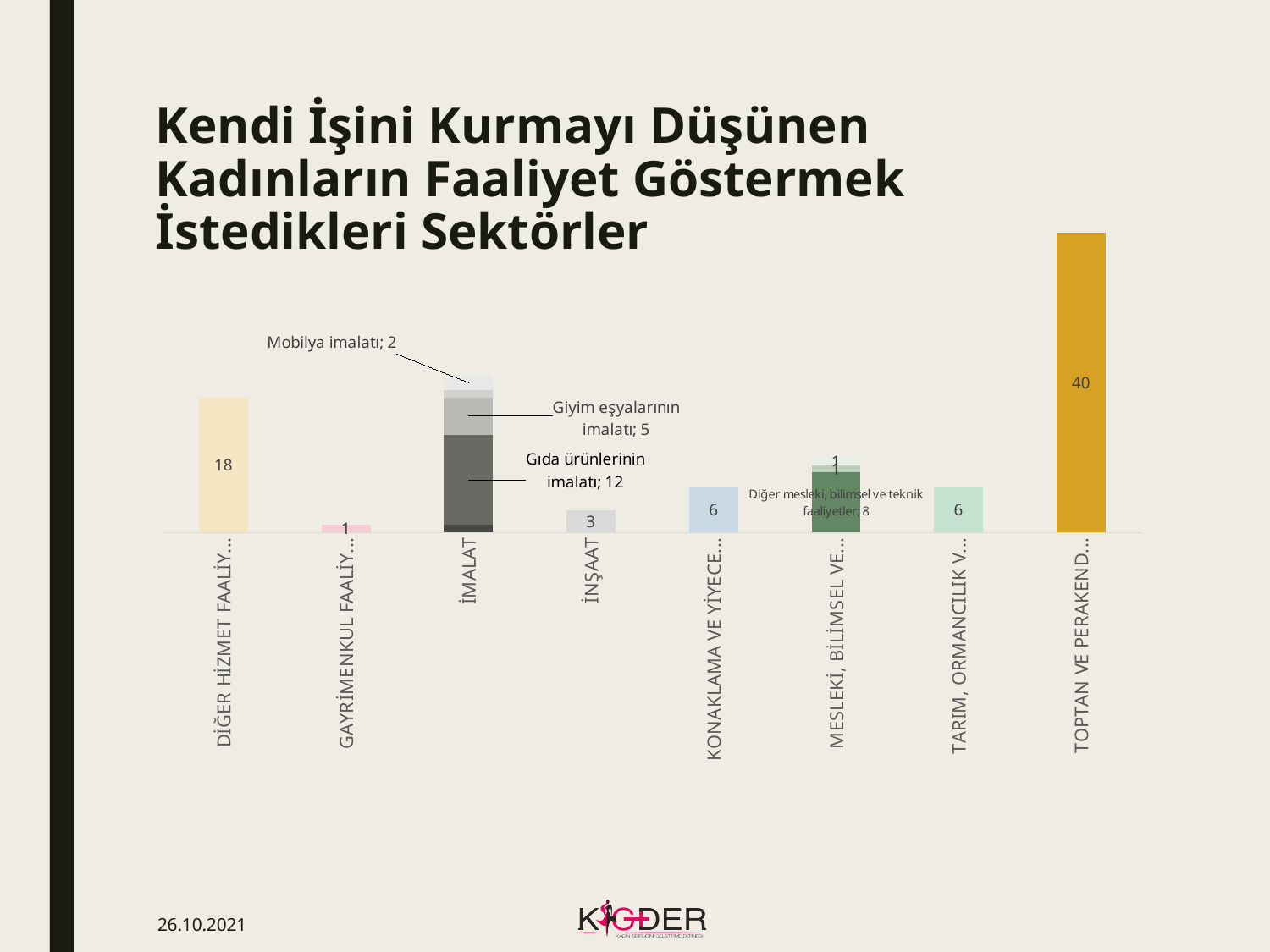
How many categories are shown on the x axis of the chart? 8 What is the value for the DİĞER HİZMET FAALİY... category? 18 What is the value of the 'Mobilya imalatı' segment in the İMALAT bar? 2 What is the difference between the values for TOPTAN VE PERAKEND... and DİĞER HİZMET FAALİY...? 22 What is the value of the 'Giyim eşyalarının imalatı' segment in the İMALAT bar? 5 Which category has the highest bar? TOPTAN VE PERAKEND... What is the value of the 'Gıda ürünlerinin imalatı' segment in the İMALAT bar? 12 Which is larger, the value for KONAKLAMA VE YİYECE... or the value for İNŞAAT? KONAKLAMA VE YİYECE... Which category has the lowest bar? GAYRİMENKUL FAALİY... What is the value of the 'Diğer mesleki, bilimsel ve teknik faaliyetler' segment? 8 What is the value for the TOPTAN VE PERAKEND... category? 40 What is the value for the İNŞAAT category? 3